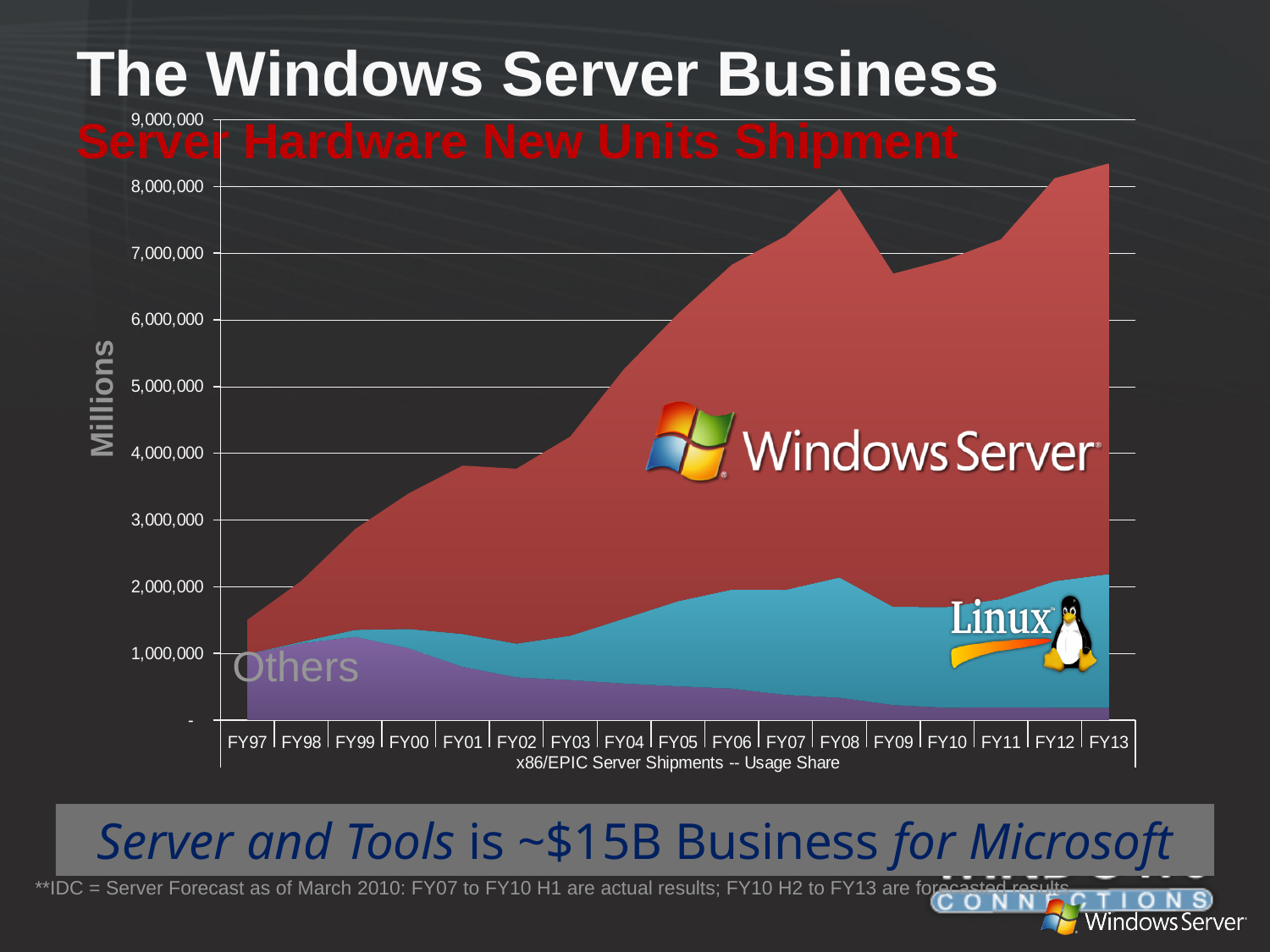
Is the total server shipment value for FY97 greater or less than 1,000,000? greater What kind of chart is shown on the slide? Stacked area chart Which fiscal year has the highest total server shipments? FY13 Is the total server shipment value for FY09 greater or less than 7,000,000? less How many fiscal years are shown along the x axis of the chart? 17 Which fiscal year has the lowest total server shipments? FY97 Which series is shown at the bottom of the stacked area chart? Others How many data series are shown in the chart? 3 What is the title of the chart? Server Hardware New Units Shipment Is the value for the Others series in FY13 greater or less than 1,000,000? less Do total server shipments generally rise or fall from FY97 to FY13? rise